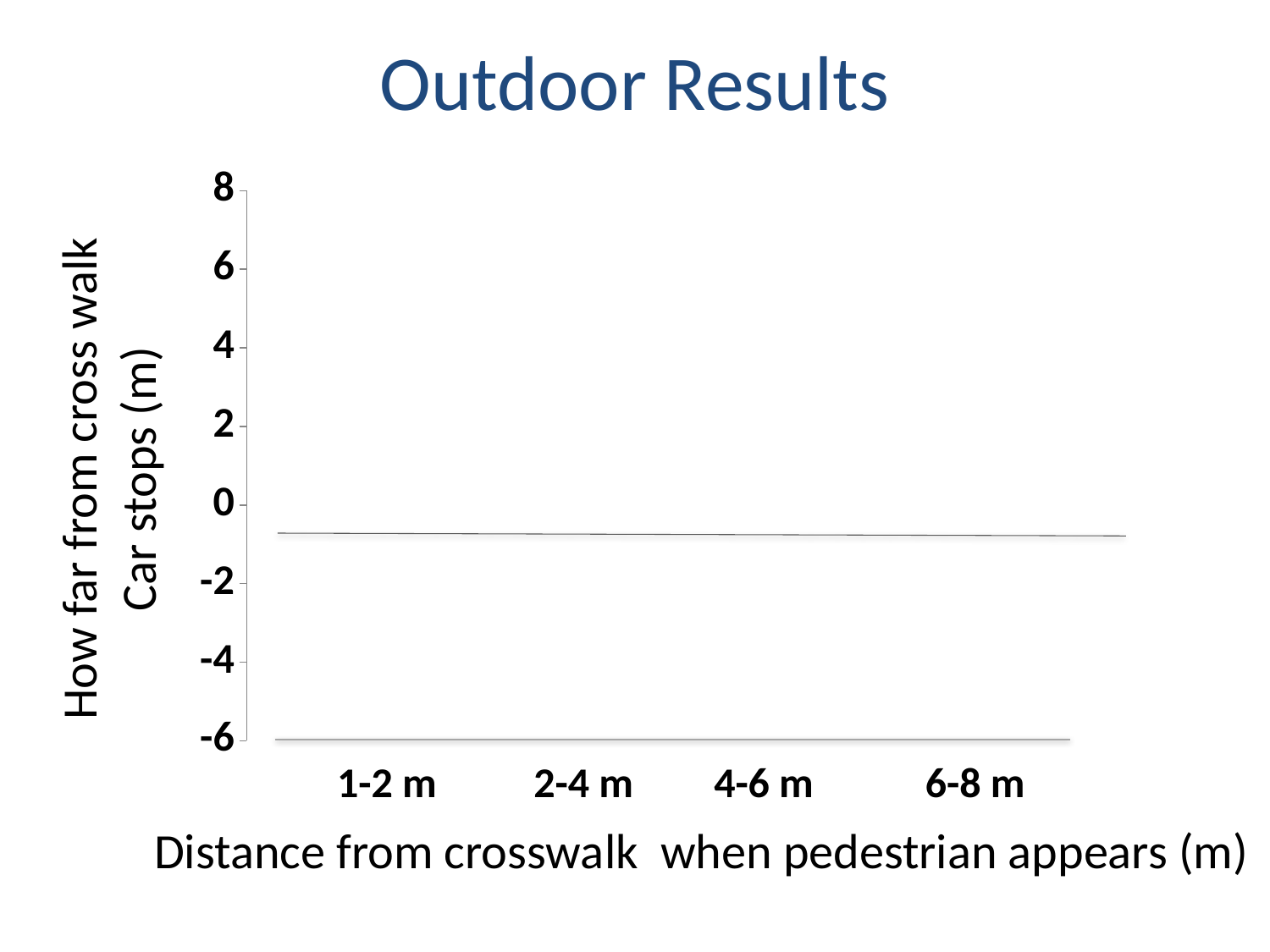
How many categories are shown on the x axis of the chart? 4 What is the x-axis title of the chart? Distance from crosswalk when pedestrian appears (m) What is the title of the slide containing the chart? Outdoor Results Is the horizontal line plotted across the chart at a value greater or less than -2? greater Is the horizontal line plotted across the chart at a value greater or less than 0? less